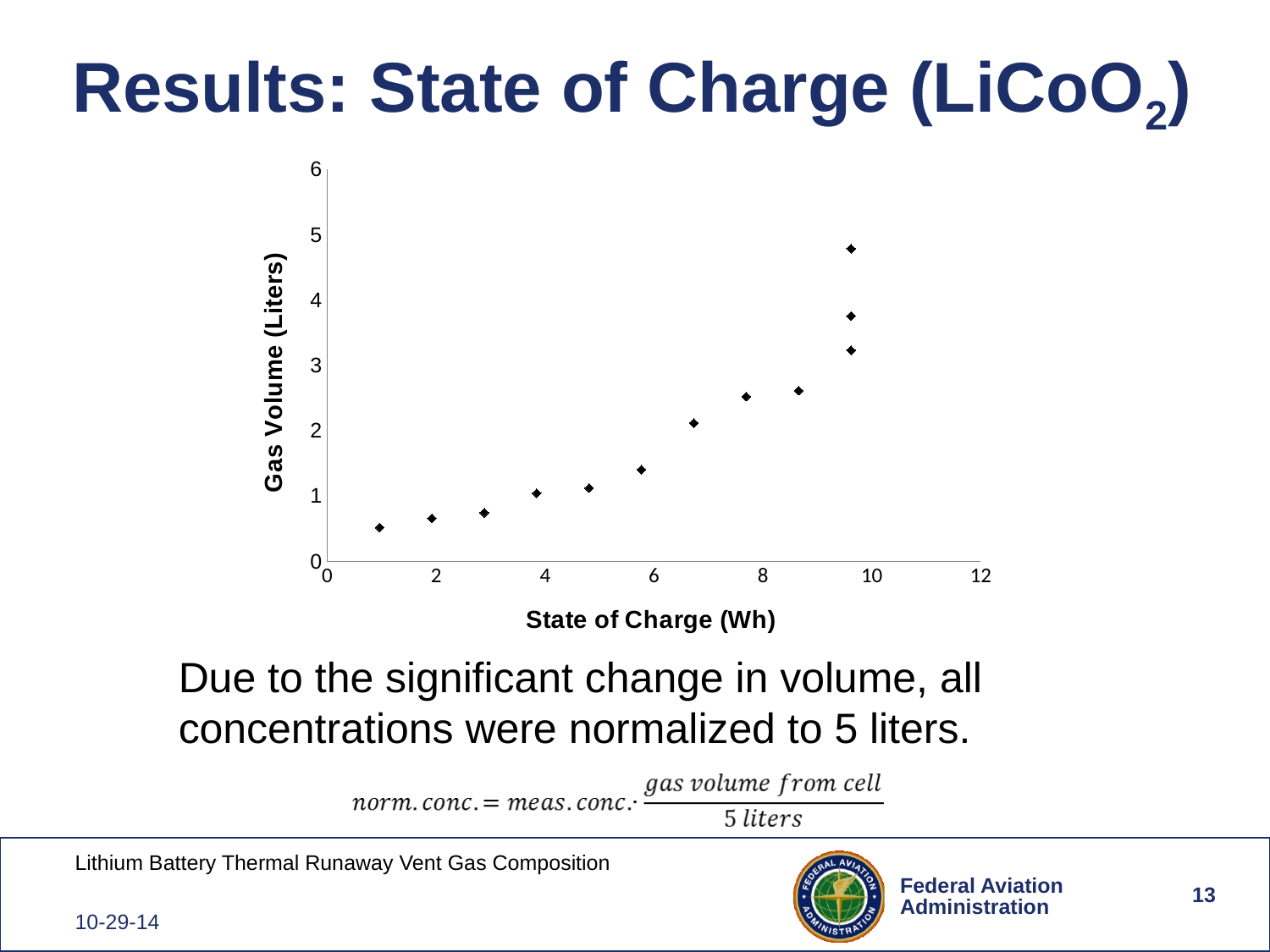
Is the gas volume for the point at roughly 1 Wh state of charge greater or less than 1 liter? less Is the highest gas volume value plotted greater or less than 4 liters? greater Is the gas volume for the point at roughly 4 Wh state of charge greater or less than 2 liters? less How many data points are plotted on the chart? 12 Which has the larger gas volume: the point at roughly 2 Wh or the point at roughly 7 Wh? the point at roughly 7 Wh What is the label of the x axis? State of Charge (Wh) Do the gas volume values generally rise or fall as state of charge increases along the x axis? rise What is the label of the y axis? Gas Volume (Liters) What kind of chart is shown on the slide? scatter chart